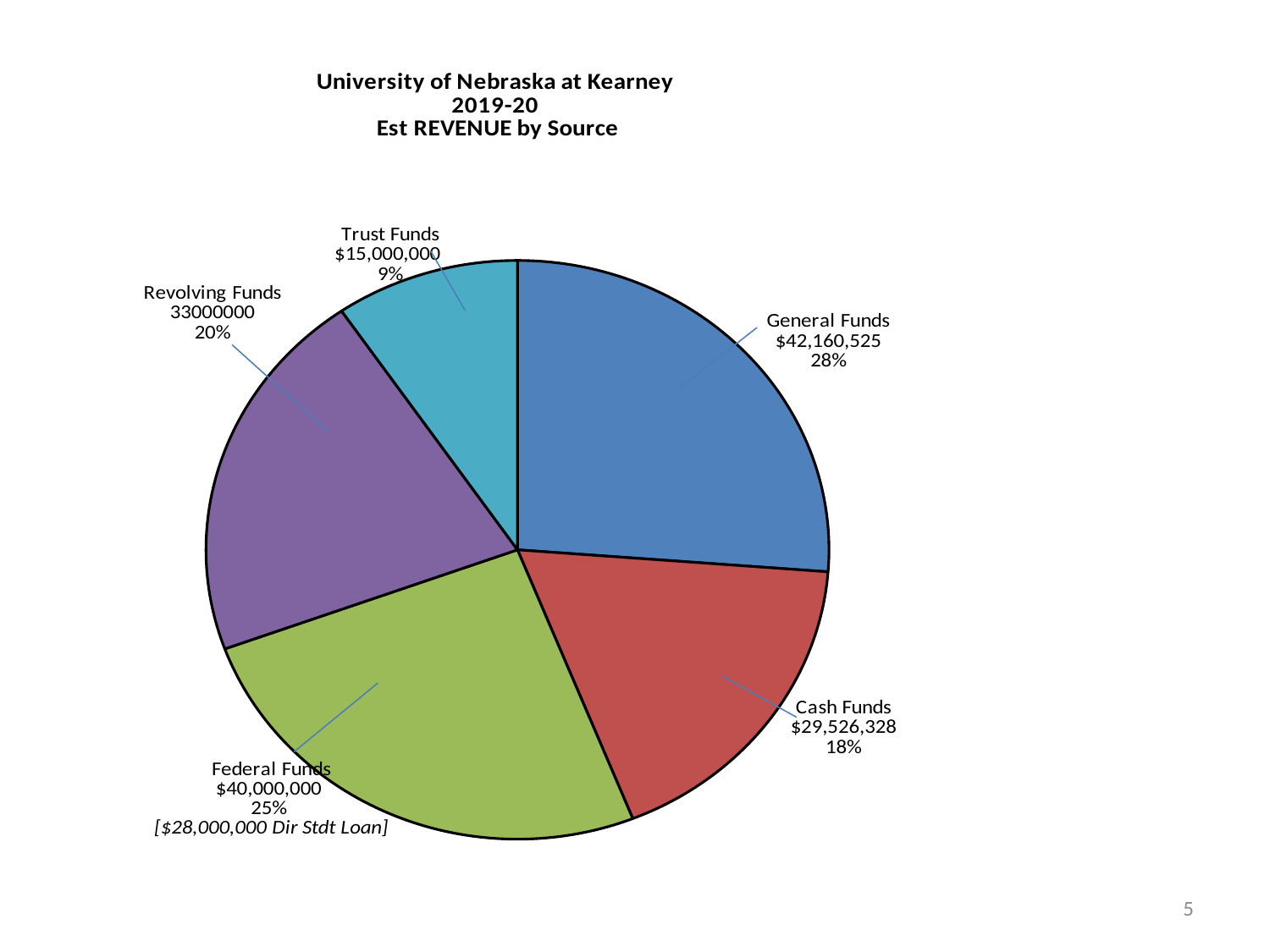
Which revenue source has the largest share of the pie? General Funds What is the estimated revenue from General Funds? $42,160,525 What is the estimated revenue from Trust Funds? $15,000,000 What share of the pie does Federal Funds represent? 25% What share of the pie does Revolving Funds represent? 20% What type of chart is shown on the slide? Pie chart Which is larger, the revenue from Federal Funds or from Cash Funds? Federal Funds What is the estimated revenue from Cash Funds? $29,526,328 What is the title of the chart? University of Nebraska at Kearney 2019-20 Est REVENUE by Source Which revenue source has the smallest share of the pie? Trust Funds How many revenue sources are shown in the pie chart? 5 What is the difference in revenue between Federal Funds and Trust Funds? $25,000,000